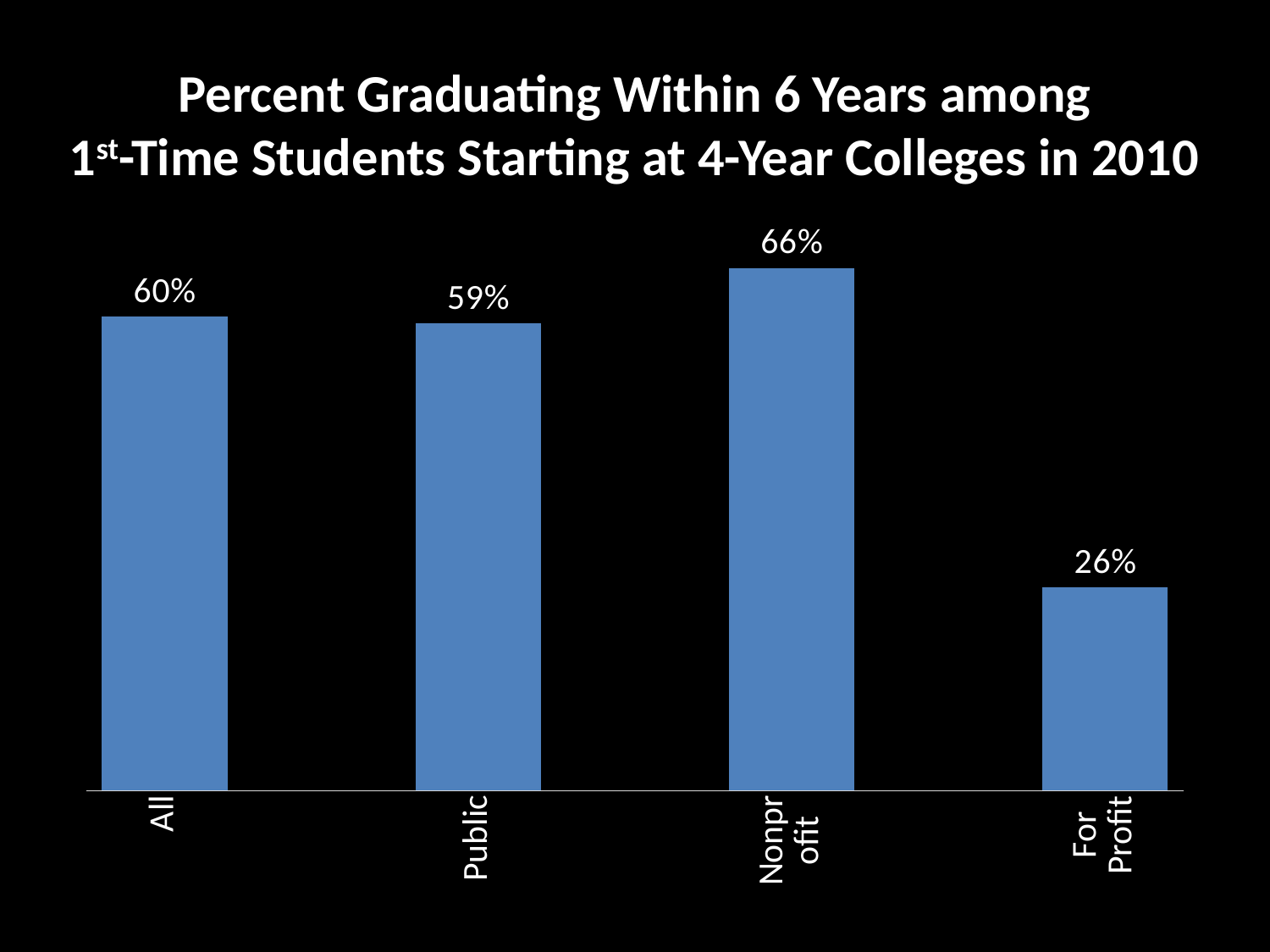
What kind of chart is shown on the slide? Bar chart What is the difference between the All and Public graduation rates? 1% What is the percent graduating within 6 years for Public colleges? 59% How many categories are shown in the chart? 4 What colour are the bars in the chart? Blue What is the percent graduating within 6 years for Nonprofit colleges? 66% Which has a higher graduation rate, Public or For Profit? Public Which category has the highest graduation rate? Nonprofit Which category has the lowest graduation rate? For Profit What is the percent graduating within 6 years for All students? 60% What is the difference between the Nonprofit and For Profit graduation rates? 40% What is the percent graduating within 6 years for For Profit colleges? 26%